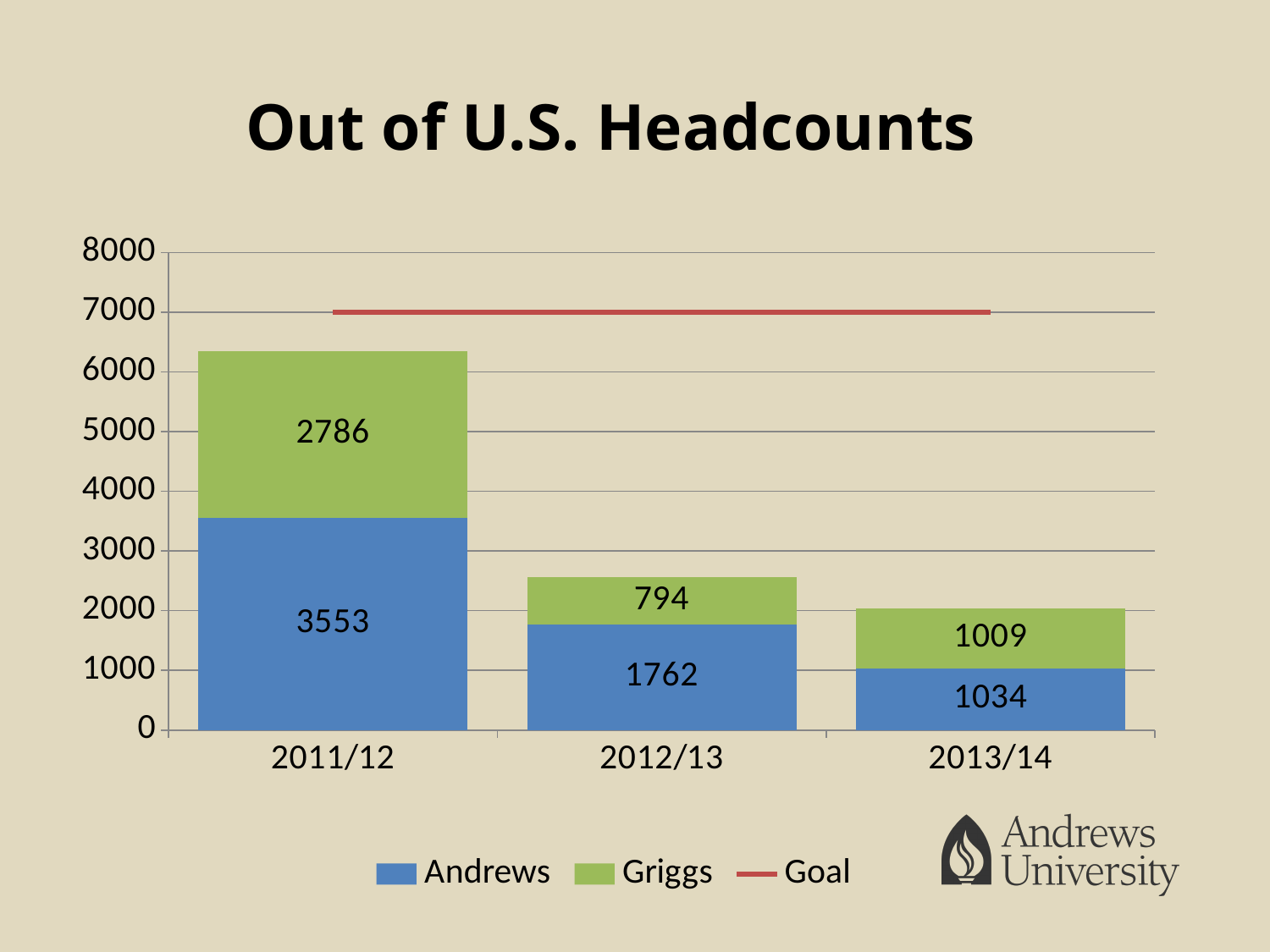
Which year has the highest Griggs headcount? 2011/12 What is the Griggs headcount for 2012/13? 794 What is the difference between the Andrews headcounts for 2011/12 and 2012/13? 1791 How many series does the legend list? 3 Which is larger in 2012/13, the Andrews headcount or the Griggs headcount? Andrews Which year has the lowest Andrews headcount? 2013/14 What is the total headcount (Andrews plus Griggs) for 2013/14? 2043 What is the total headcount (Andrews plus Griggs) for 2011/12? 6339 What is the Andrews headcount for 2011/12? 3553 Is the Goal line greater or less than 6000? greater How many years are shown on the x axis? 3 What is the Andrews headcount for 2013/14? 1034